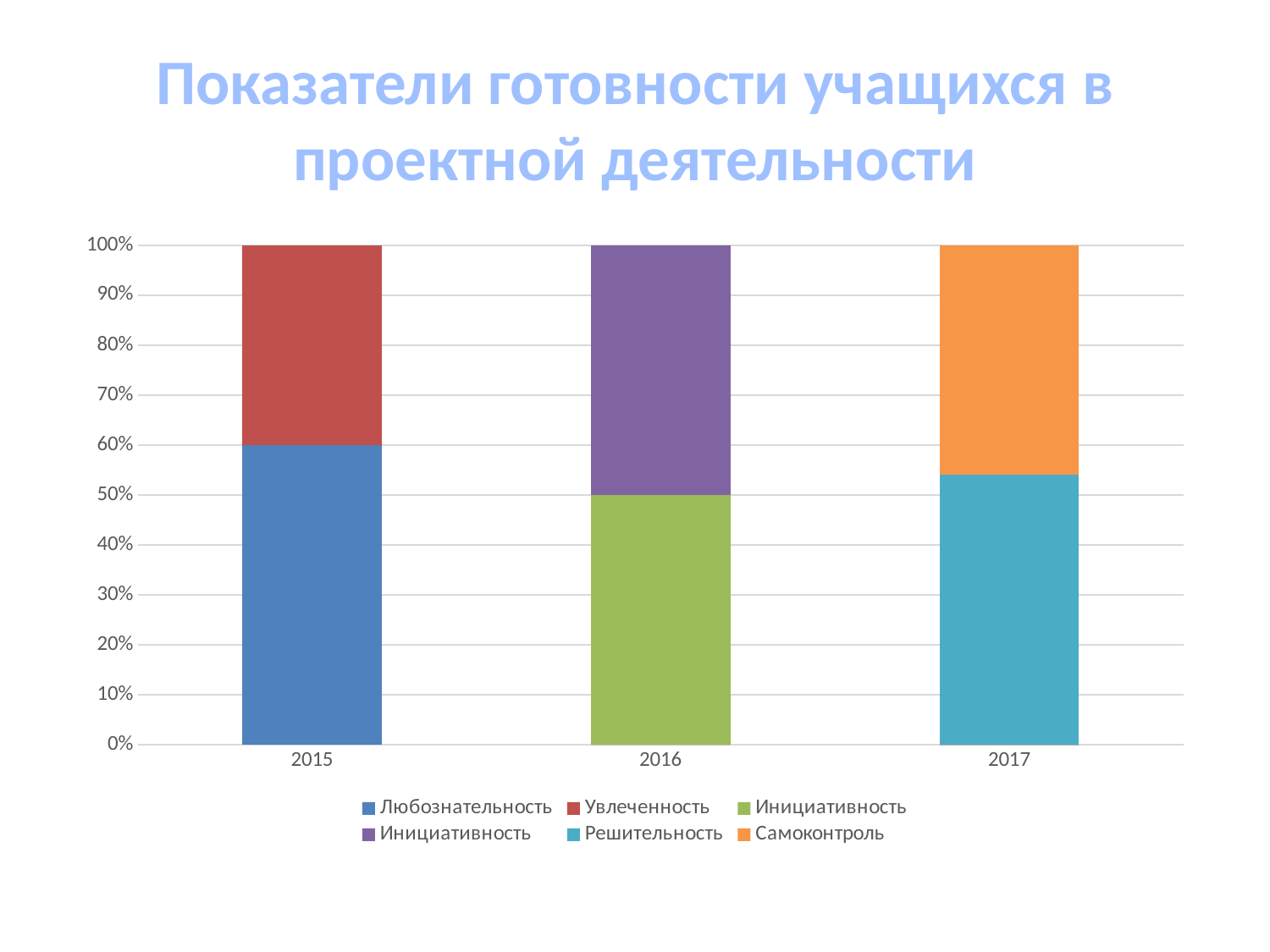
How many series does the chart legend list? 6 Is the value for Решительность in 2017 greater or less than 50%? greater Is the green Инициативность segment in 2016 greater or less than 60%? less What is the total of the stacked bar for 2015? 100% What is the value of Любознательность in 2015? 60% Which is larger: Любознательность in 2015 or the green Инициативность segment in 2016? Любознательность in 2015 What is the title of the chart on the slide? Показатели готовности учащихся в проектной деятельности How many years are shown on the x axis of the chart? 3 What kind of chart is shown on the slide? Stacked bar chart Is the value for Любознательность in 2015 greater or less than 50%? greater What is the value of the green Инициативность segment in 2016? 50%